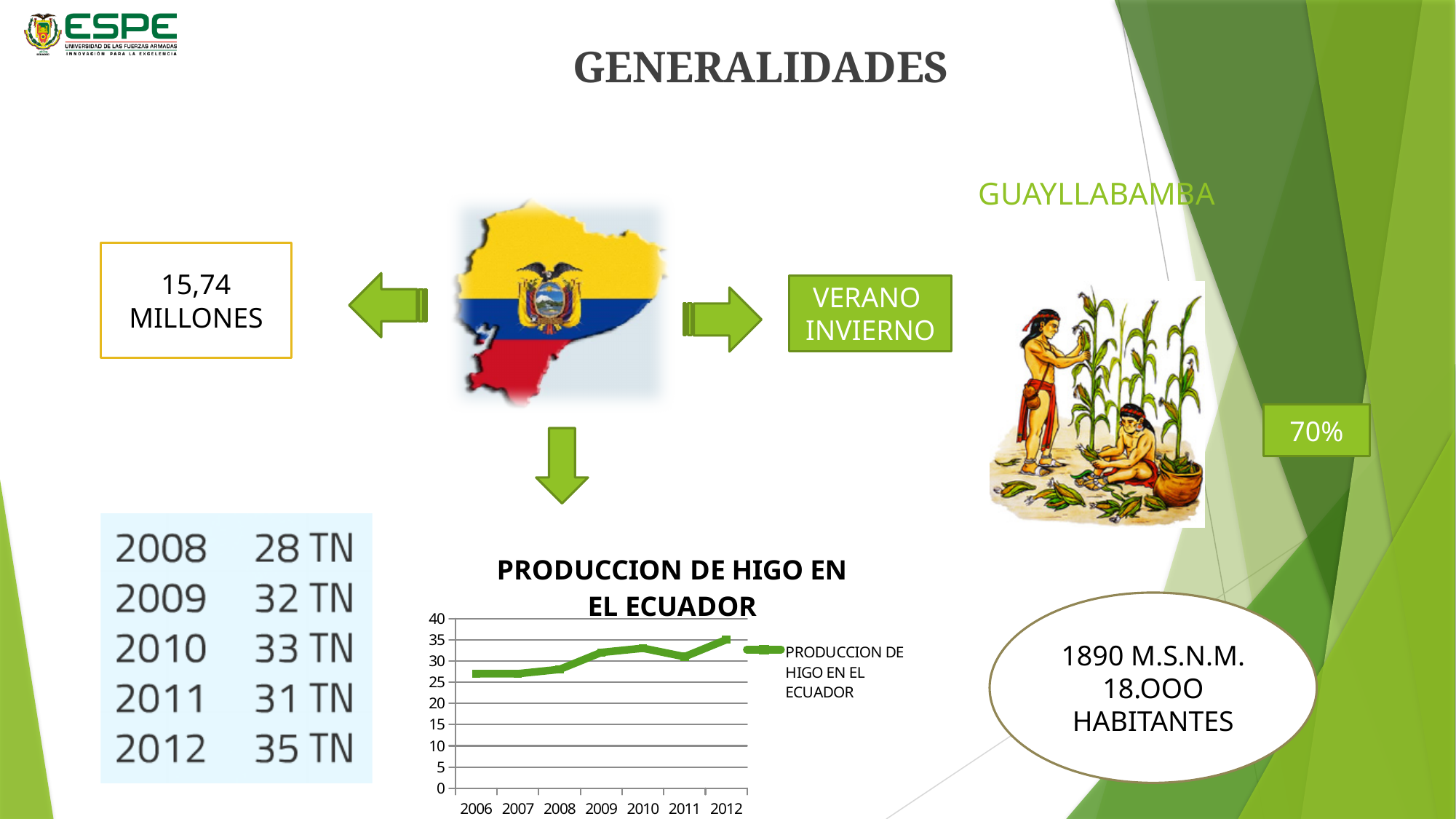
According to the table on the slide, what was the fig production in Ecuador in 2012? 35 TN What is the legend entry of the 'PRODUCCION DE HIGO EN EL ECUADOR' chart? PRODUCCION DE HIGO EN EL ECUADOR In the 'PRODUCCION DE HIGO EN EL ECUADOR' chart, is the value for 2012 greater or less than 30? greater How many years are plotted on the x axis of the 'PRODUCCION DE HIGO EN EL ECUADOR' chart? 7 In the 'PRODUCCION DE HIGO EN EL ECUADOR' chart, is the value for 2006 greater or less than 30? less Overall, do the values in the 'PRODUCCION DE HIGO EN EL ECUADOR' chart rise or fall from 2006 to 2012? rise What kind of chart is 'PRODUCCION DE HIGO EN EL ECUADOR'? line chart In the 'PRODUCCION DE HIGO EN EL ECUADOR' chart, which is larger, the value for 2010 or the value for 2011? 2010 How many series does the legend of the 'PRODUCCION DE HIGO EN EL ECUADOR' chart list? 1 In the 'PRODUCCION DE HIGO EN EL ECUADOR' chart, which year has the highest value? 2012 In the 'PRODUCCION DE HIGO EN EL ECUADOR' chart, is the value for 2010 greater or less than 30? greater In the 'PRODUCCION DE HIGO EN EL ECUADOR' chart, which is larger, the value for 2008 or the value for 2009? 2009